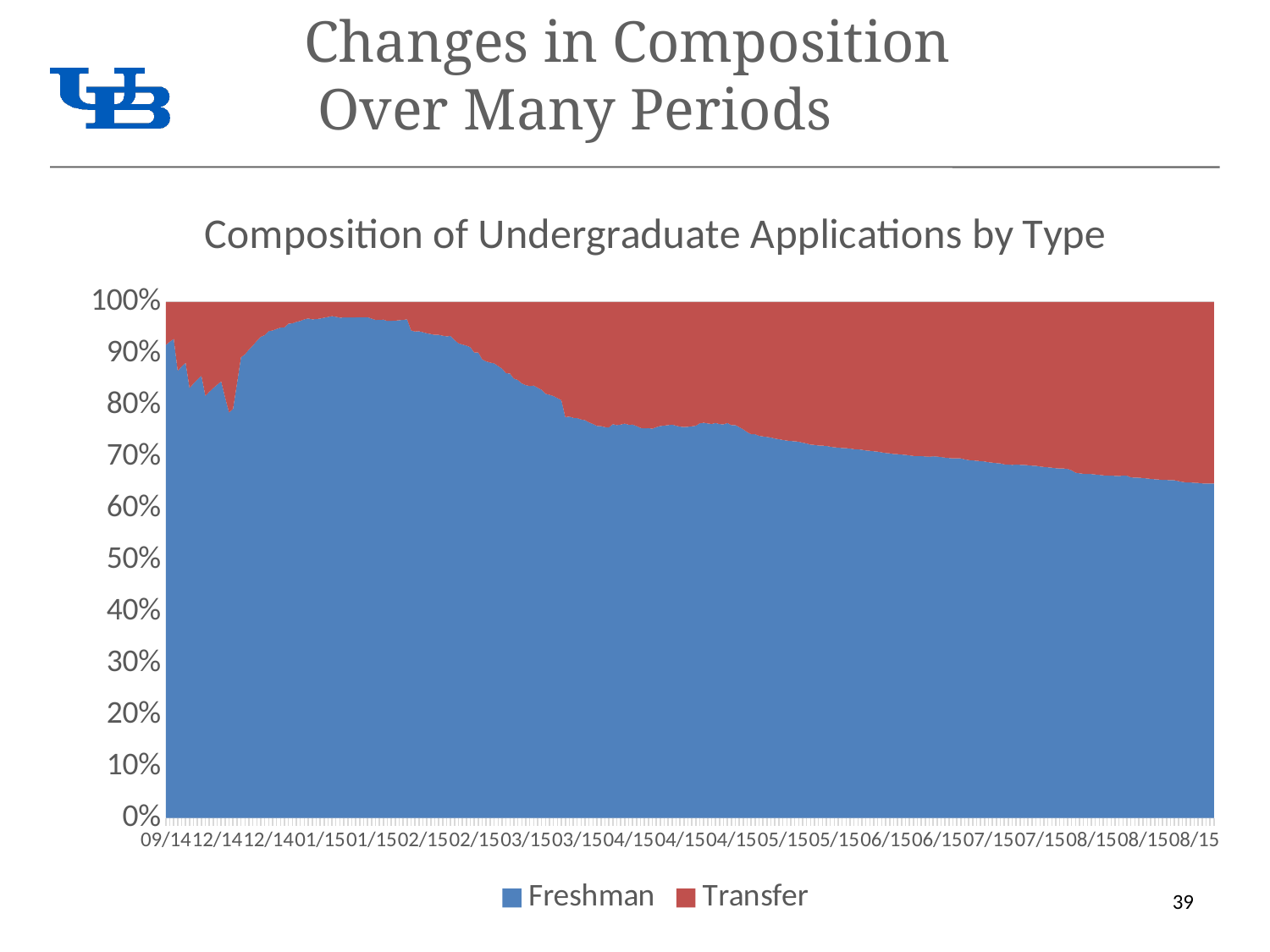
Is the Freshman share at the last period (08/15) greater or less than 60%? greater Does the Transfer share rise or fall from 01/15 to 08/15? rise At the last period (08/15), which series has the larger share, Freshman or Transfer? Freshman Is the Transfer share at the last period (08/15) greater or less than 30%? greater Is the Transfer share around 01/15 greater or less than 10%? less What is the title of the chart? Composition of Undergraduate Applications by Type What kind of chart is shown on the slide? Stacked area chart How many series does the legend list? 2 Which series is shown in red? Transfer Does the Freshman share rise or fall from 01/15 to 08/15? fall